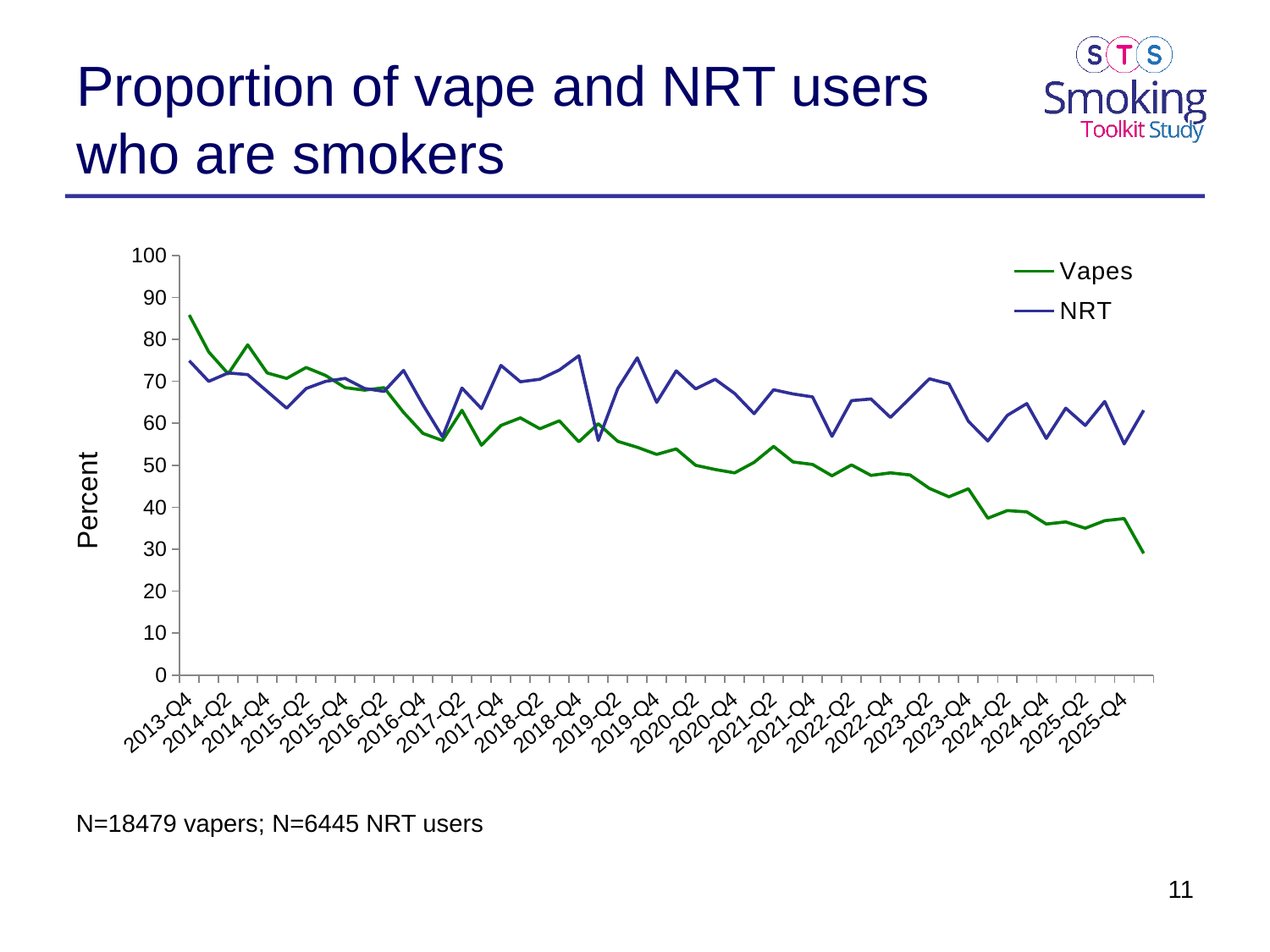
Is the value for NRT at 2013-Q4 greater or less than 70? greater What kind of chart is shown on the slide? line chart Which two series are listed in the legend? Vapes and NRT Is the value for NRT at 2025-Q4 greater or less than 60? less How many series does the legend list? 2 At 2013-Q4, which series has the higher value, Vapes or NRT? Vapes Does the Vapes line generally rise or fall from 2013-Q4 to 2025-Q4? fall What is the label on the vertical axis? Percent At 2025-Q4, which series has the higher value, Vapes or NRT? NRT Is the value for Vapes at 2025-Q4 greater or less than 40? less